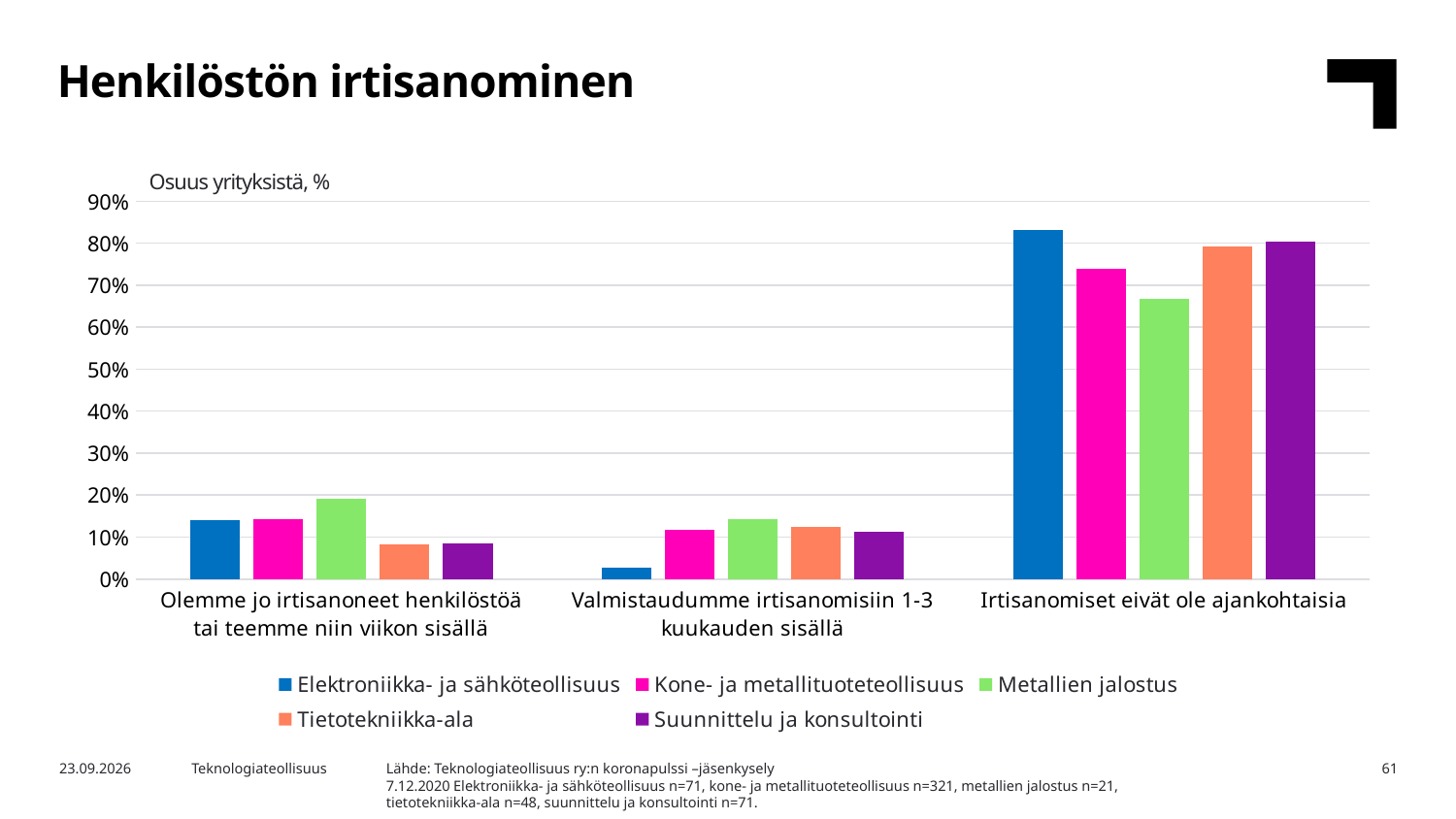
Is the value for Metallien jalostus in the category 'Irtisanomiset eivät ole ajankohtaisia' greater or less than 70%? less In the category 'Valmistaudumme irtisanomisiin 1-3 kuukauden sisällä', which series has the lowest value? Elektroniikka- ja sähköteollisuus In the category 'Irtisanomiset eivät ole ajankohtaisia', which series has the lowest value? Metallien jalostus Is the value for Elektroniikka- ja sähköteollisuus in the category 'Valmistaudumme irtisanomisiin 1-3 kuukauden sisällä' greater or less than 10%? less In the category 'Olemme jo irtisanoneet henkilöstöä tai teemme niin viikon sisällä', which is larger: Metallien jalostus or Tietotekniikka-ala? Metallien jalostus In the category 'Irtisanomiset eivät ole ajankohtaisia', which is larger: Tietotekniikka-ala or Kone- ja metallituoteteollisuus? Tietotekniikka-ala In the category 'Irtisanomiset eivät ole ajankohtaisia', which series has the highest value? Elektroniikka- ja sähköteollisuus How many series does the legend list? 5 What label is shown above the vertical axis of the chart? Osuus yrityksistä, % What kind of chart is shown on the slide? Bar chart How many categories are shown on the x axis? 3 In the category 'Olemme jo irtisanoneet henkilöstöä tai teemme niin viikon sisällä', which series has the highest value? Metallien jalostus